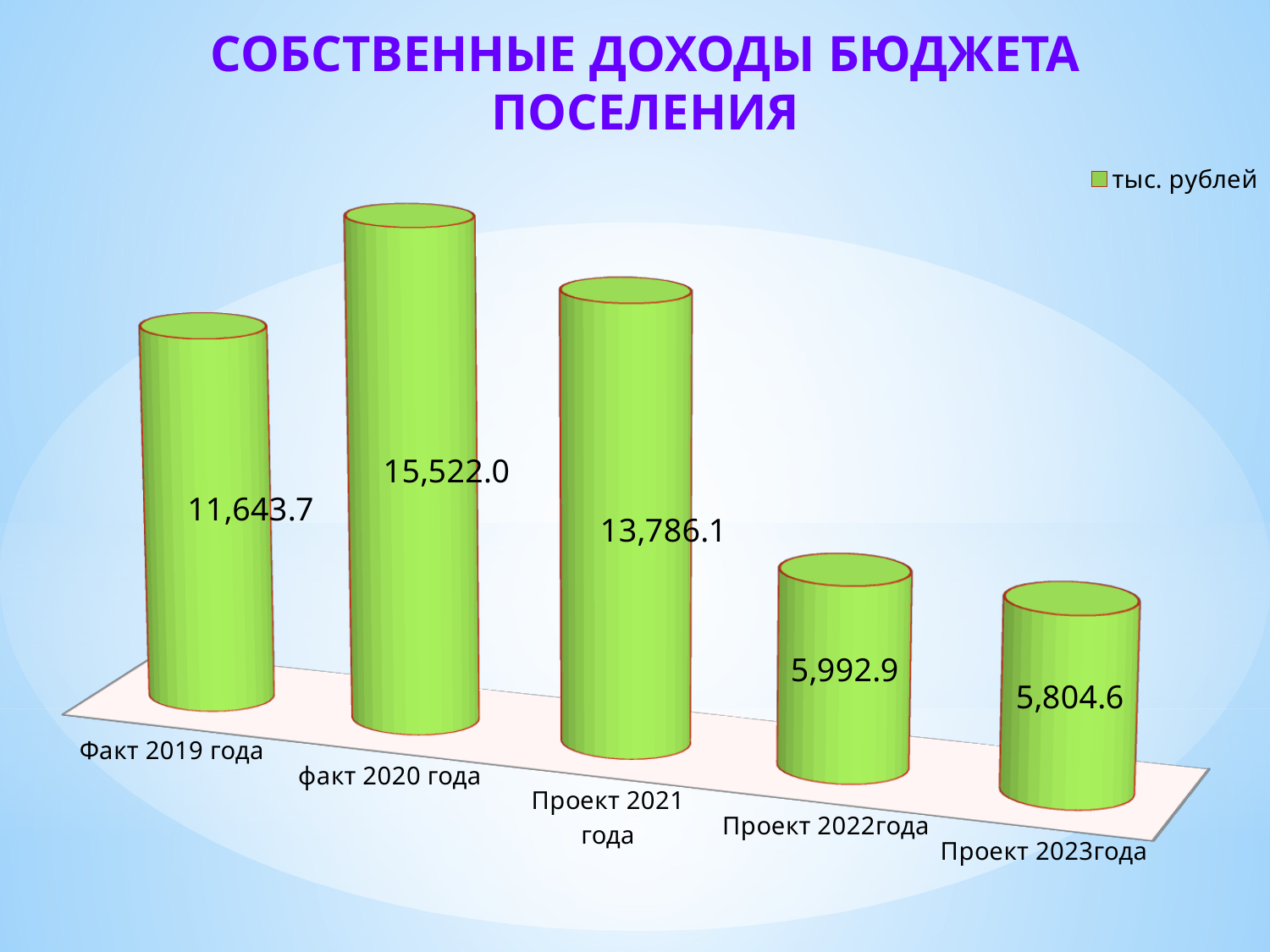
What is the value for факт 2020 года? 15,522.0 What is the difference between the values for Проект 2022года and Проект 2023года? 188.3 Which is larger, the value for Проект 2022года or Проект 2023года? Проект 2022года Which category has the highest value? факт 2020 года What is the value for Проект 2021 года? 13,786.1 Which category has the lowest value? Проект 2023года What is the legend entry shown for the chart? тыс. рублей How many categories are shown in the chart? 5 What is the value for Проект 2023года? 5,804.6 What is the difference between the values for факт 2020 года and Факт 2019 года? 3,878.3 What kind of chart is shown on the slide? Bar chart What is the value for Факт 2019 года? 11,643.7